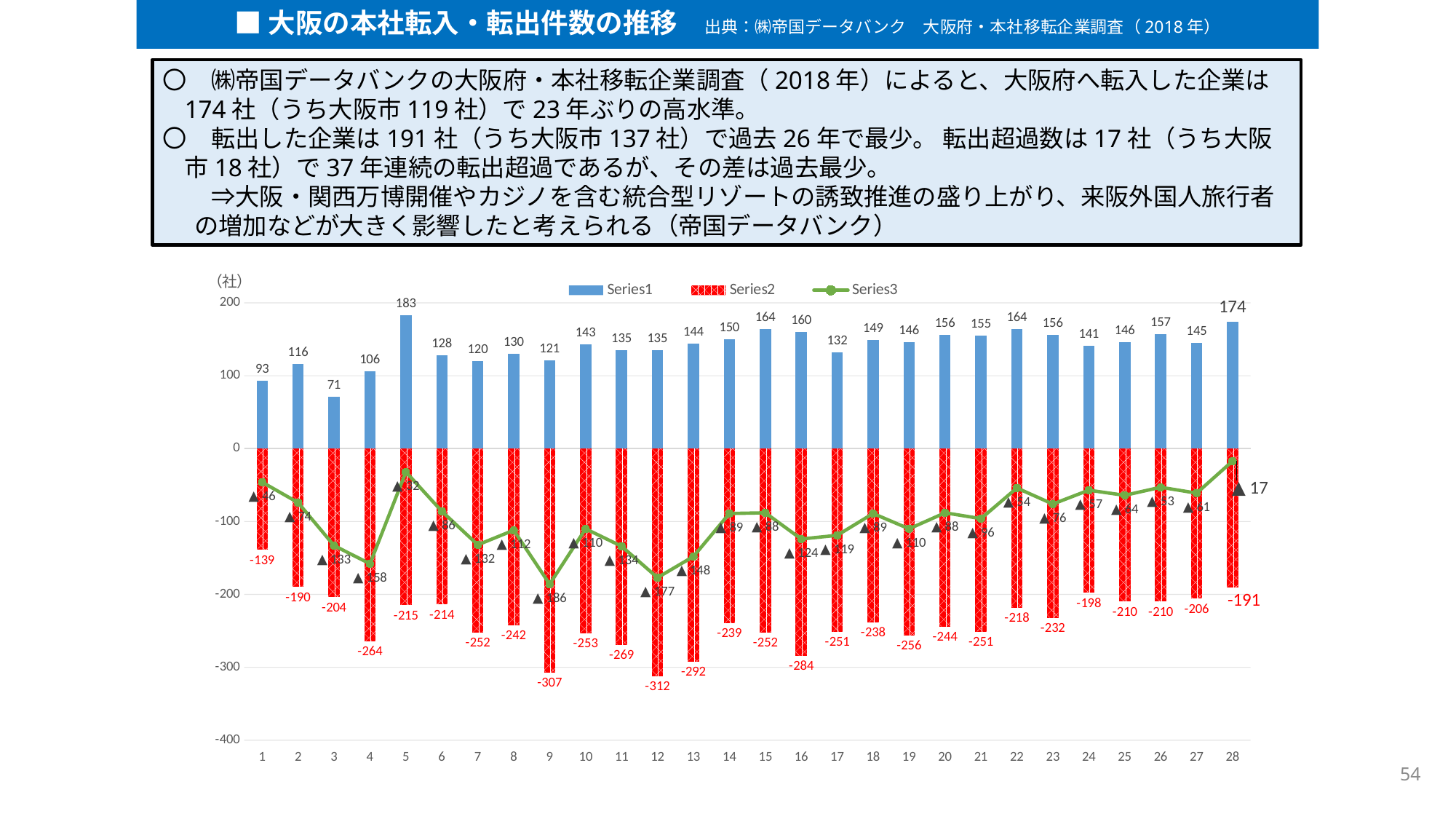
What kind of chart is shown on the slide? Combined bar and line chart What is the value of Series2 at category 12? -312 What is the value of Series2 at category 1? -139 How many series does the legend list? 3 Which category has the highest Series1 value? 5 What is the value of Series1 at category 28? 174 Which category has the lowest Series2 value? 12 How many categories are shown on the x axis? 28 Which category has the lowest Series1 value? 3 What is the difference between the Series1 values at category 28 and category 1? 81 What is the value of Series1 at category 5? 183 Is the Series1 value at category 17 larger or smaller than the Series1 value at category 18? smaller